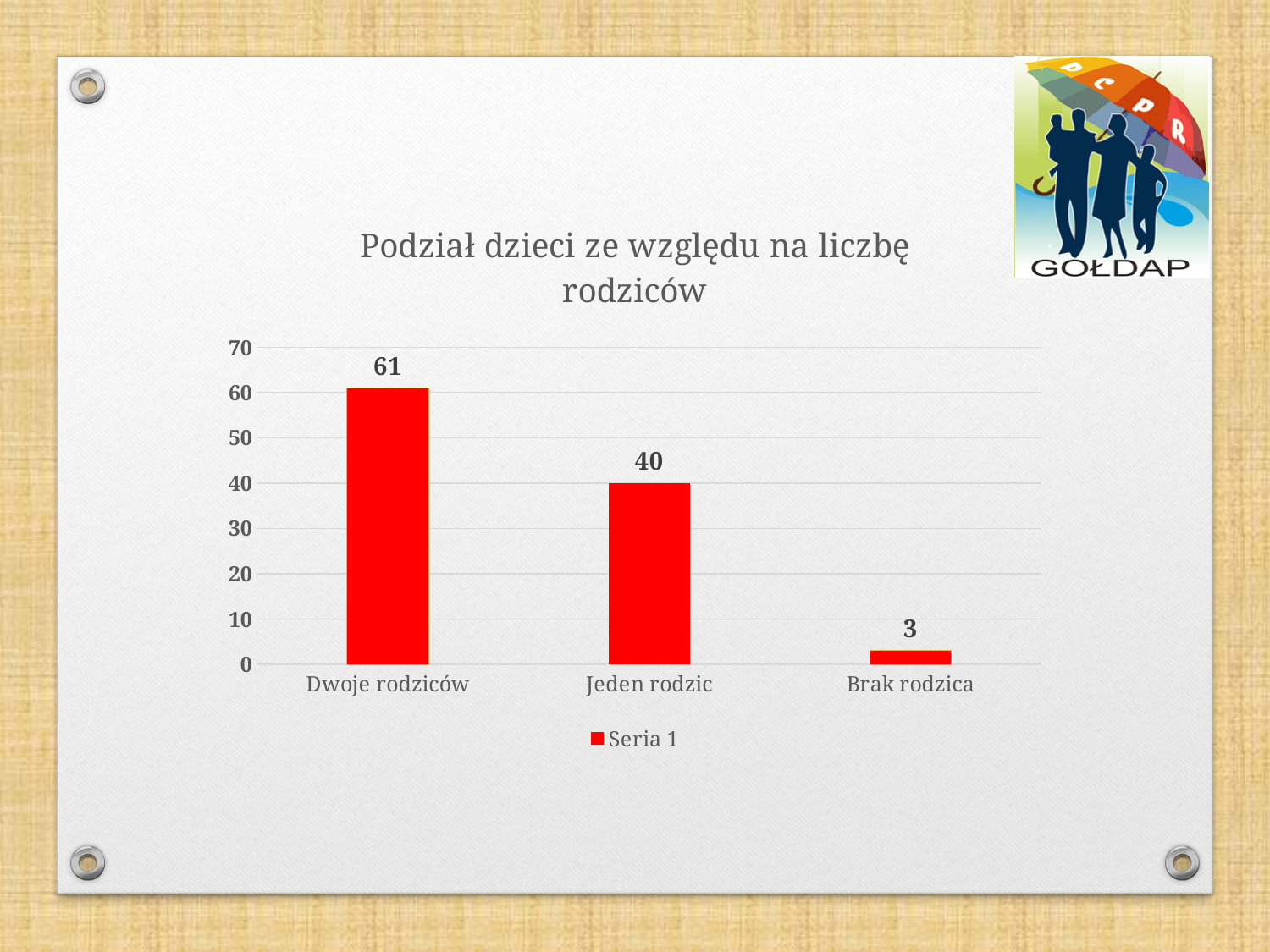
What is the value for Brak rodzica? 3 What is the title of the chart? Podział dzieci ze względu na liczbę rodziców What kind of chart is shown on the slide? bar chart Which is larger, the value for Jeden rodzic or the value for Brak rodzica? Jeden rodzic What is the difference between the values for Jeden rodzic and Brak rodzica? 37 Which category has the lowest value? Brak rodzica What is the difference between the values for Dwoje rodziców and Jeden rodzic? 21 Is the value for Jeden rodzic greater or less than 50? less How many categories are shown on the x axis? 3 What is the value for Dwoje rodziców? 61 Which category has the highest value? Dwoje rodziców What is the value for Jeden rodzic? 40